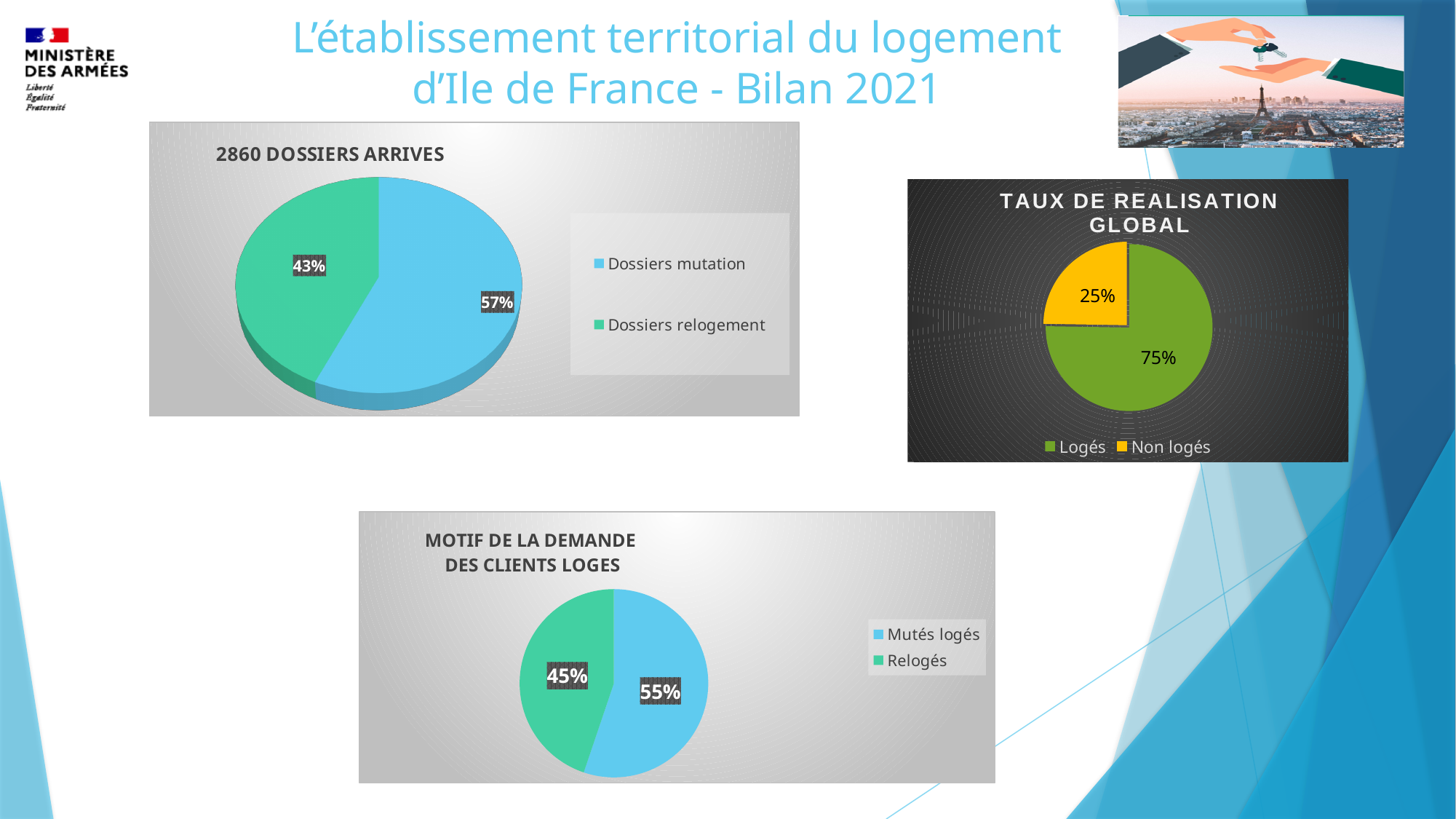
What kind of chart is the 'TAUX DE REALISATION GLOBAL' chart? Pie chart In the '2860 DOSSIERS ARRIVES' chart, what share is Dossiers mutation? 57% How many entries does the legend of the 'MOTIF DE LA DEMANDE DES CLIENTS LOGES' chart list? 2 In the 'MOTIF DE LA DEMANDE DES CLIENTS LOGES' chart, what share is Mutés logés? 55% In the 'TAUX DE REALISATION GLOBAL' chart, which category has the smallest slice? Non logés In the 'TAUX DE REALISATION GLOBAL' chart, what share is Non logés? 25% In the '2860 DOSSIERS ARRIVES' chart, what is the difference between Dossiers mutation and Dossiers relogement? 14% In the 'MOTIF DE LA DEMANDE DES CLIENTS LOGES' chart, which is larger, Mutés logés or Relogés? Mutés logés In the '2860 DOSSIERS ARRIVES' chart, which category has the largest slice? Dossiers mutation